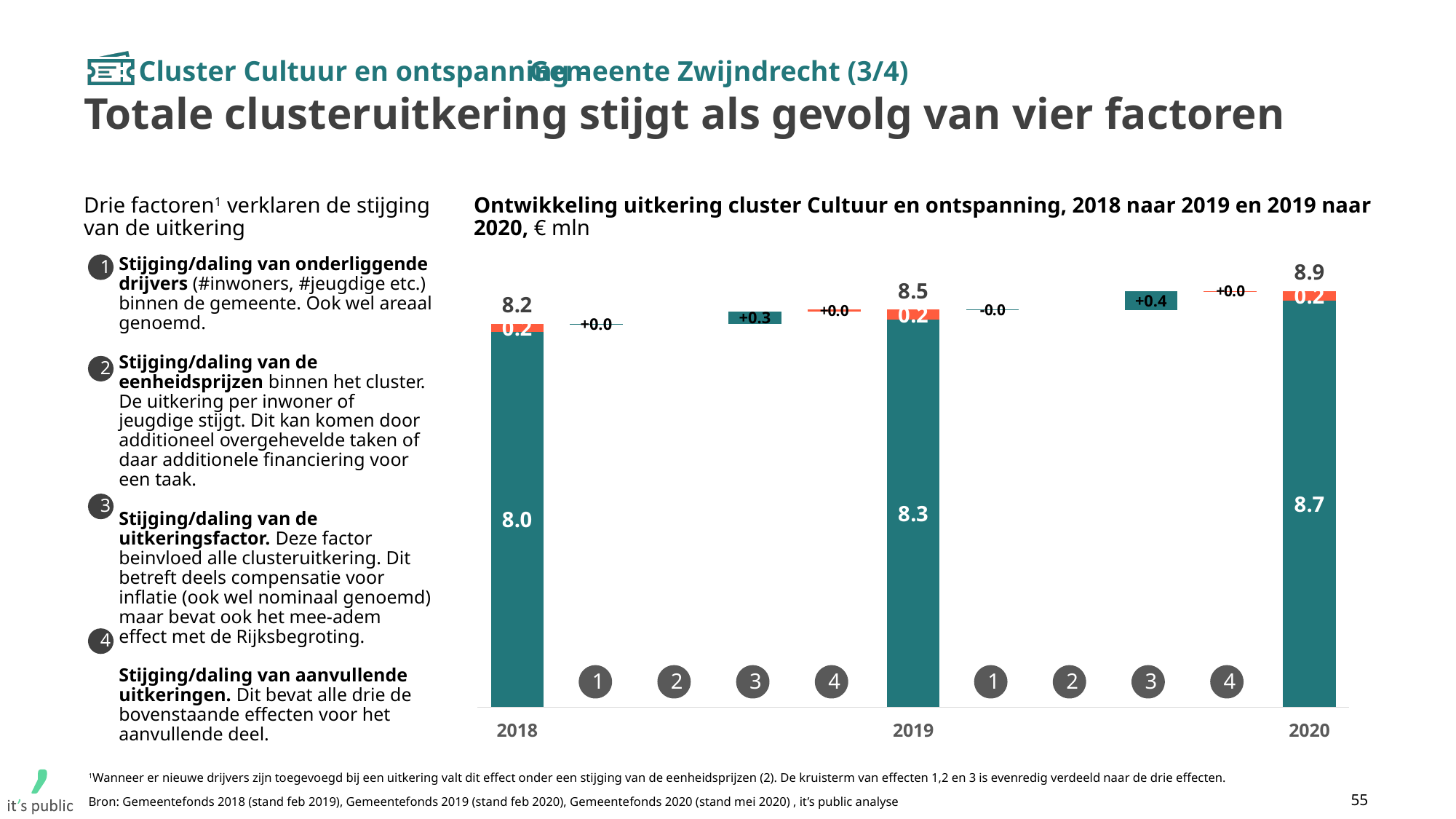
What is the total uitkering shown for 2020? 8.9 What is the effect of factor 3 on the change from 2018 to 2019? +0.3 How many years are shown as full bars in the chart? 3 What is the effect of factor 3 on the change from 2019 to 2020? +0.4 Do the total uitkering values rise or fall from 2018 to 2020? rise What is the value of the large teal segment of the 2020 bar? 8.7 What is the total uitkering shown for 2019? 8.5 What is the total uitkering shown for 2018? 8.2 Which year has the lowest total uitkering? 2018 Which year has the highest total uitkering? 2020 What is the difference between the 2020 total (8.9) and the 2018 total (8.2)? 0.7 What is the value of the orange segment on top of the 2019 bar? 0.2